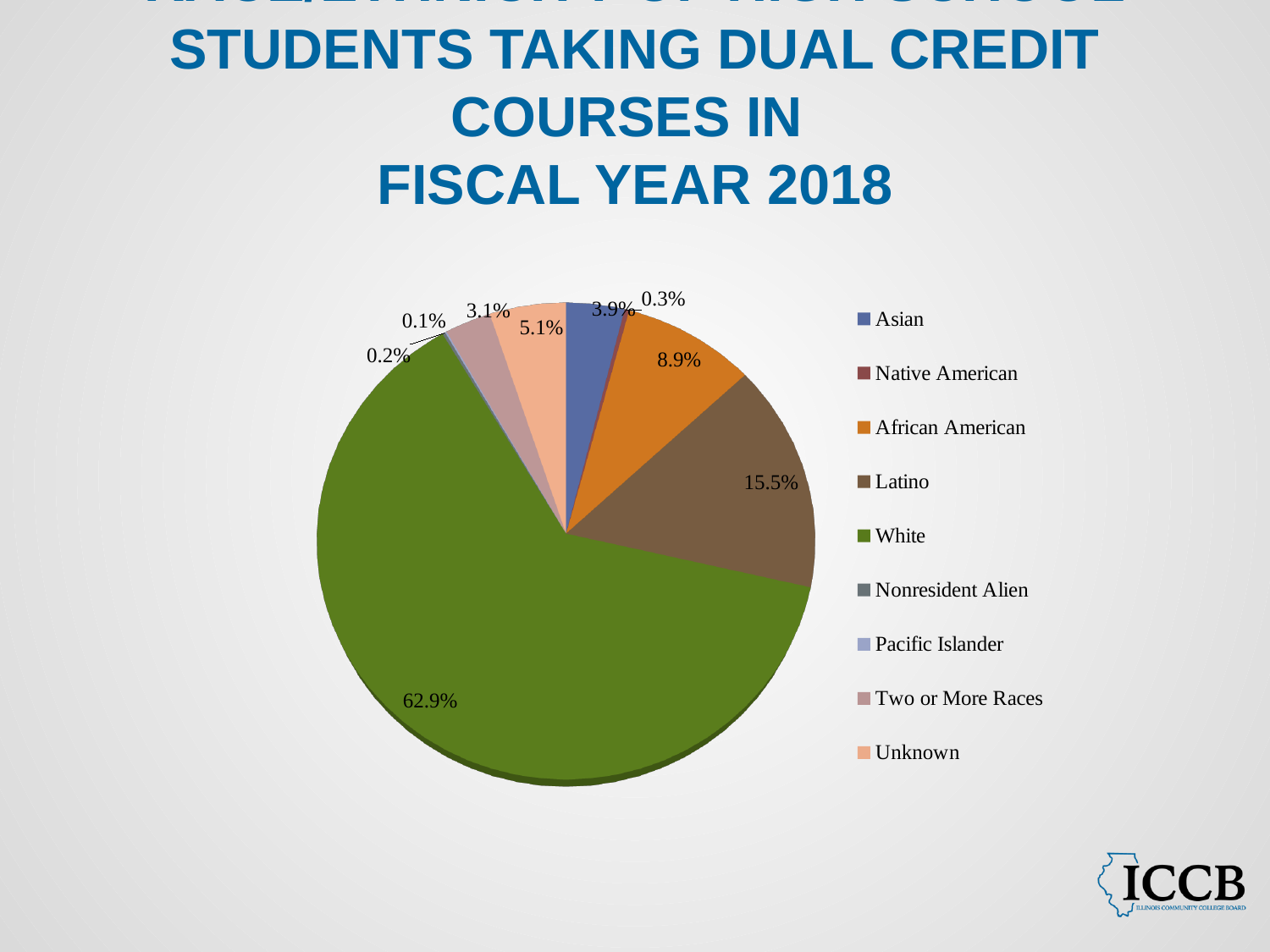
What percentage is shown for African American? 8.9% What percentage is shown for Asian? 3.9% What percentage of the pie is the White slice? 62.9% Which category has the largest share of the pie? White What type of chart is shown on the slide? Pie chart What percentage is shown for Latino? 15.5% What is the difference between the Latino and African American percentages? 6.6% Which fiscal year does the chart title refer to? Fiscal Year 2018 Which is larger, the Unknown slice or the Two or More Races slice? Unknown Which category has the smallest share of the pie? Pacific Islander What percentage is shown for Unknown? 5.1% How many categories does the legend list? 9